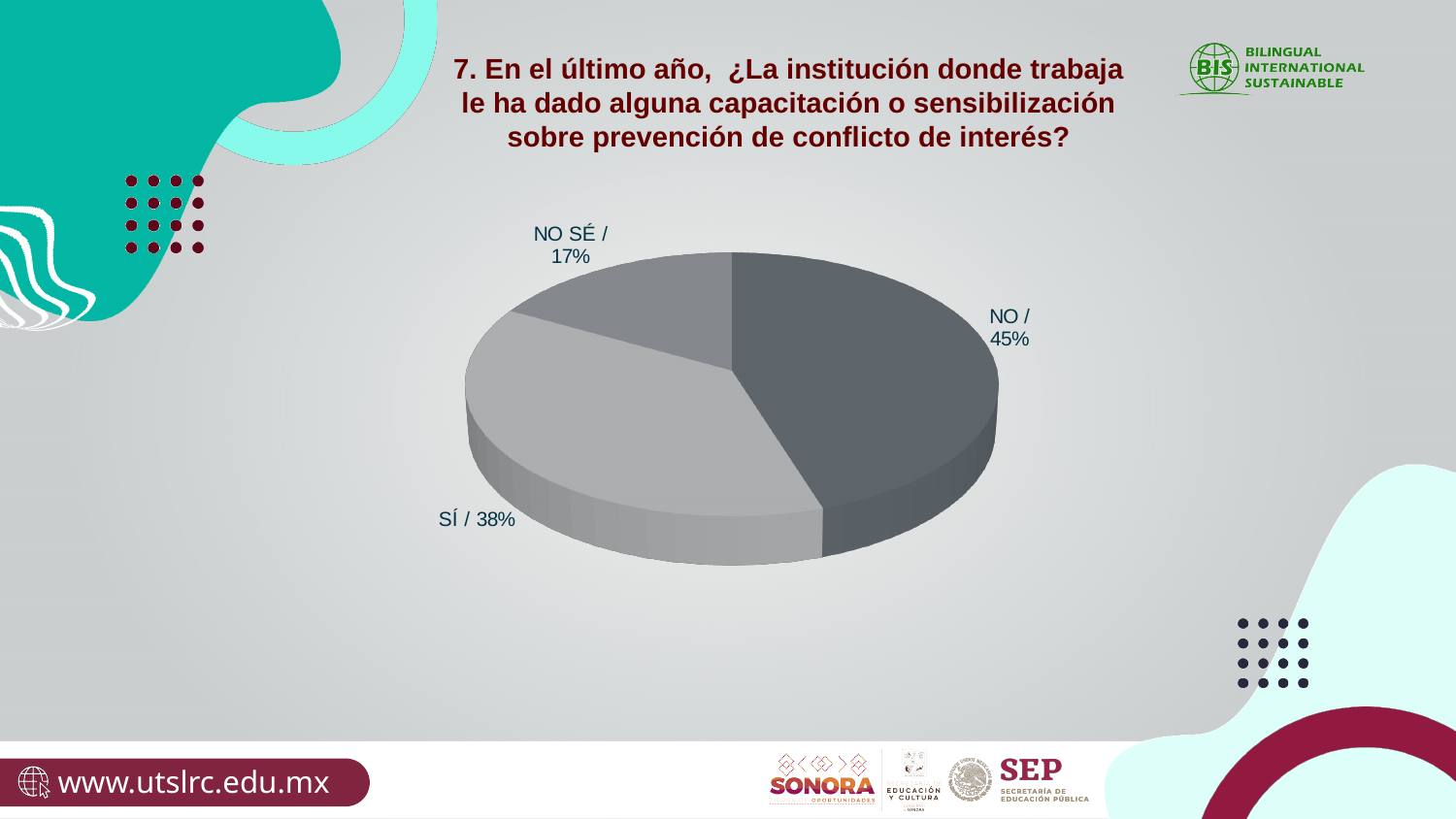
What percentage of respondents answered SÍ? 38% Which response has the largest share of the pie? NO What is the difference in percentage points between the NO and SÍ slices? 7 What percentage of respondents answered NO SÉ? 17% What share of the pie does the NO slice represent? 45% What percentage of respondents answered NO? 45% What is the difference in percentage points between the SÍ and NO SÉ slices? 21 Which is larger, the SÍ slice or the NO SÉ slice? SÍ How many slices does the pie chart have? 3 What is the question number shown in the chart title? 7 What kind of chart is shown on the slide? pie chart Which response has the smallest share of the pie? NO SÉ